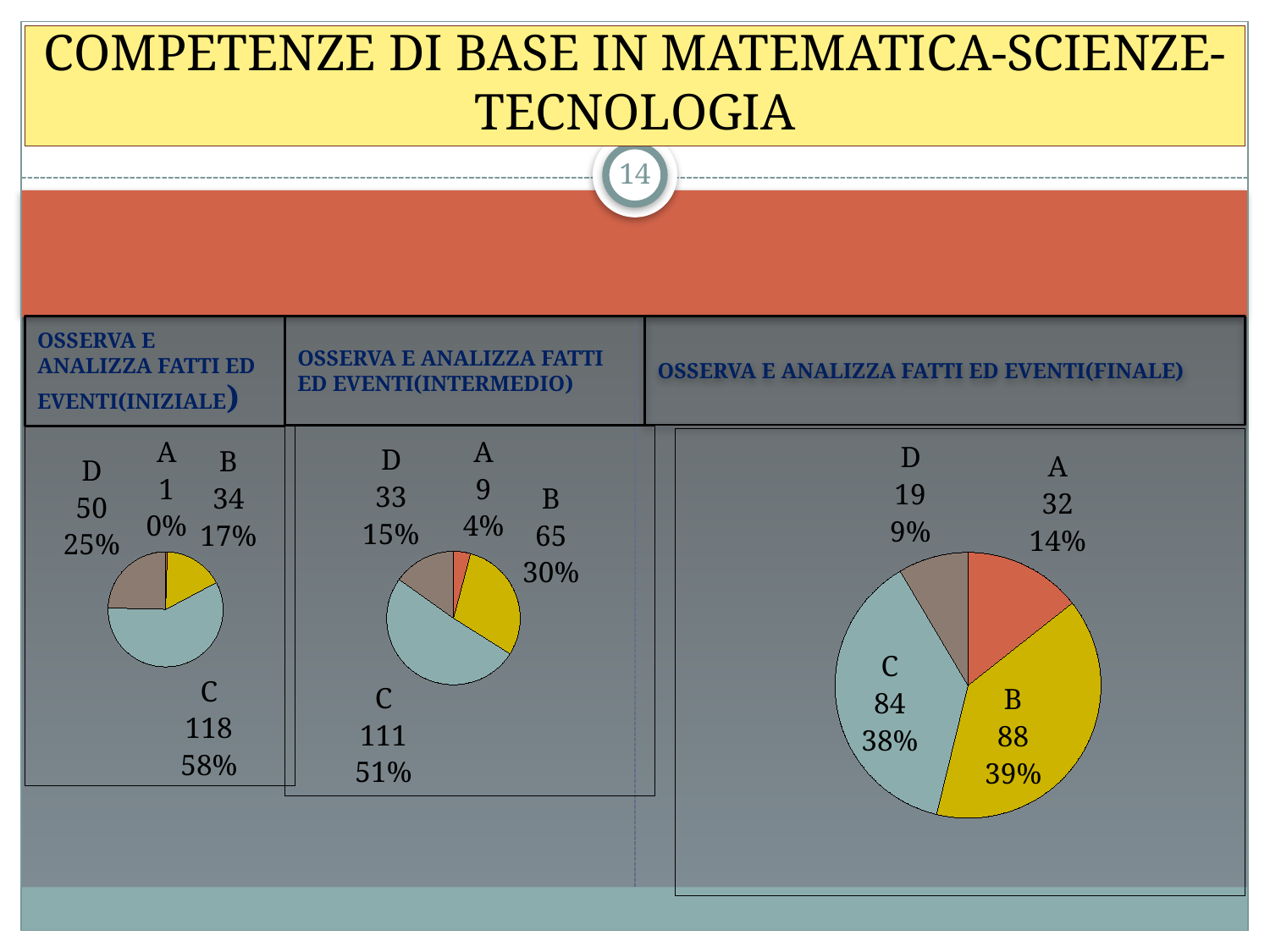
In the OSSERVA E ANALIZZA FATTI ED EVENTI(FINALE) pie chart, what is the value for A? 32 In the OSSERVA E ANALIZZA FATTI ED EVENTI(INTERMEDIO) pie chart, what share does C have? 51% In the OSSERVA E ANALIZZA FATTI ED EVENTI(FINALE) pie chart, what share does D have? 9% In the OSSERVA E ANALIZZA FATTI ED EVENTI(INIZIALE) pie chart, which category has the lowest value? A In the OSSERVA E ANALIZZA FATTI ED EVENTI(INTERMEDIO) pie chart, what is the value for B? 65 In the OSSERVA E ANALIZZA FATTI ED EVENTI(INIZIALE) pie chart, what is the value for C? 118 In the OSSERVA E ANALIZZA FATTI ED EVENTI(FINALE) pie chart, which category has the highest value? B In the OSSERVA E ANALIZZA FATTI ED EVENTI(INIZIALE) pie chart, what share does D have? 25% How many categories does the OSSERVA E ANALIZZA FATTI ED EVENTI(FINALE) pie chart show? 4 In the OSSERVA E ANALIZZA FATTI ED EVENTI(INTERMEDIO) pie chart, what is the difference between the values for C and D? 78 What kind of chart is used for OSSERVA E ANALIZZA FATTI ED EVENTI(INIZIALE)? Pie chart In the OSSERVA E ANALIZZA FATTI ED EVENTI(FINALE) pie chart, which is larger, the value for A or the value for D? A